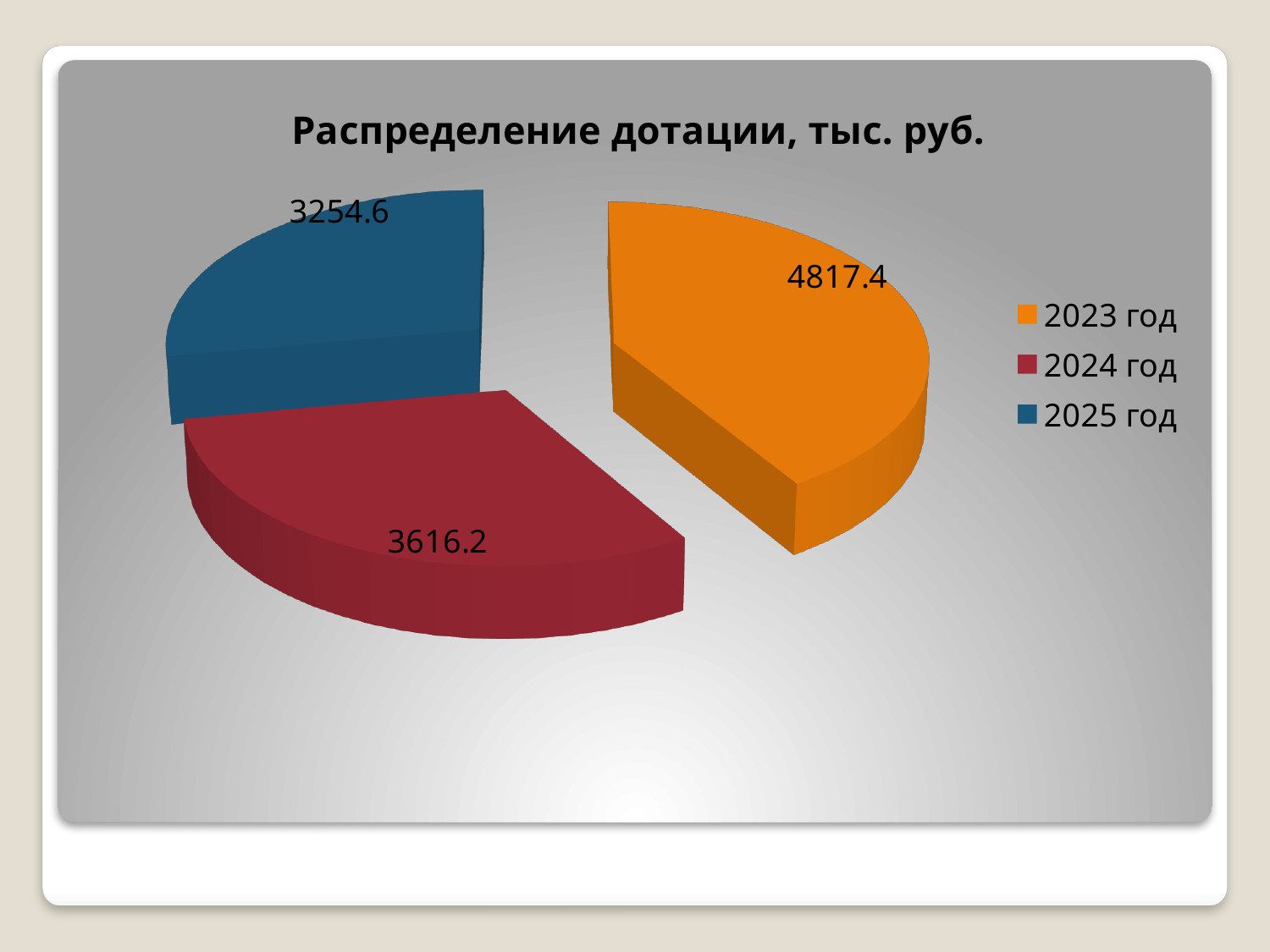
Which year has the largest slice of the pie? 2023 год What type of chart is shown on the slide? Pie chart What is the difference between the values for 2024 год and 2025 год? 361.6 What is the difference between the values for 2023 год and 2024 год? 1201.2 What is the value for 2024 год? 3616.2 Which is larger, the value for 2024 год or the value for 2025 год? 2024 год Which year has the smallest slice of the pie? 2025 год What is the value for 2023 год? 4817.4 How many slices does the pie chart have? 3 What is the value for 2025 год? 3254.6 What colour is the slice for 2025 год? Blue What is the title of the chart? Распределение дотации, тыс. руб.